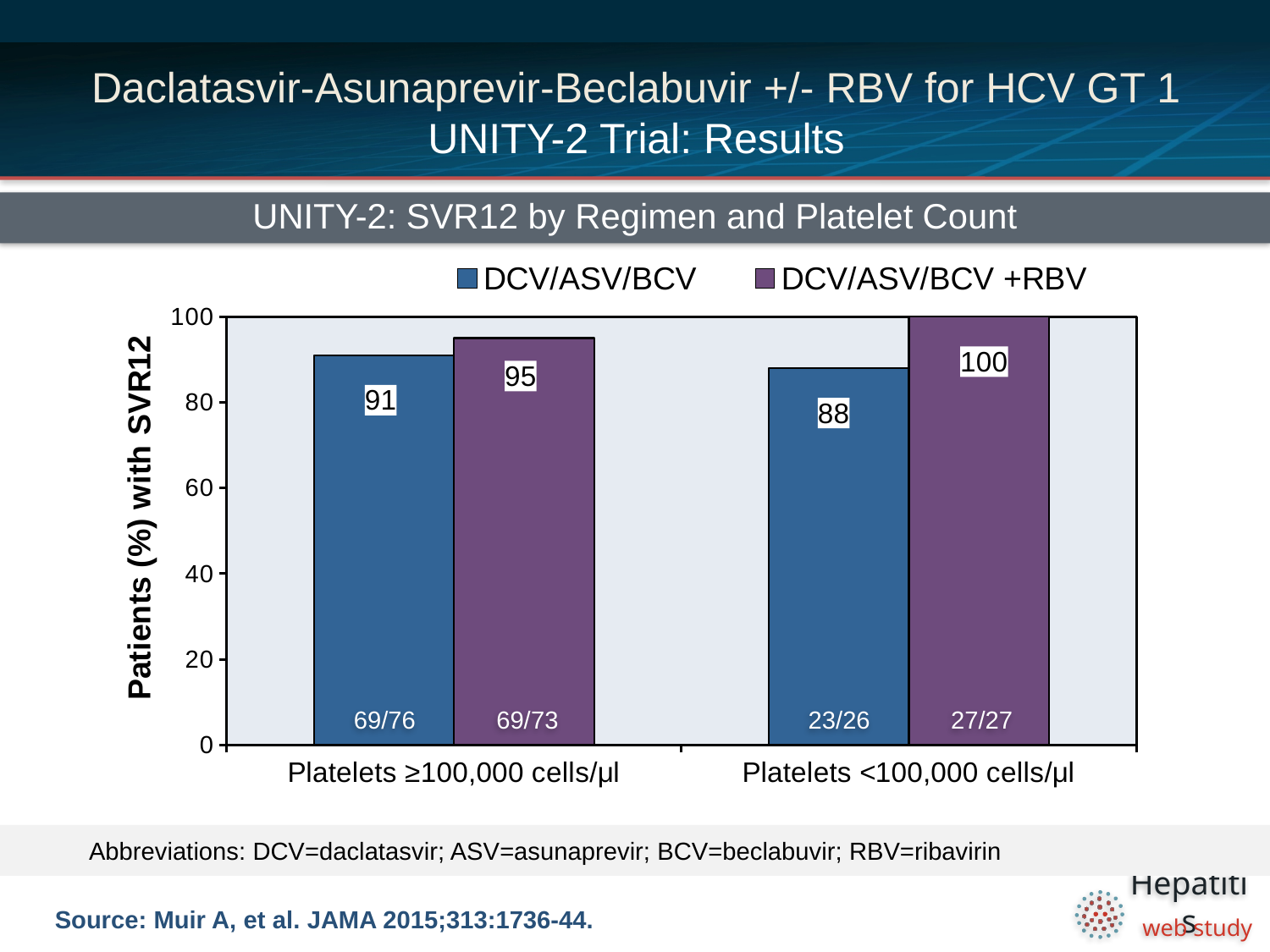
How many platelet count categories are shown on the x axis? 2 Which bar shows the highest SVR12 rate? DCV/ASV/BCV +RBV, Platelets <100,000 cells/µl Which bar shows the lowest SVR12 rate? DCV/ASV/BCV, Platelets <100,000 cells/µl What is the SVR12 rate for DCV/ASV/BCV +RBV in patients with platelets ≥100,000 cells/µl? 95 What type of chart is shown? Bar chart What is the SVR12 rate for DCV/ASV/BCV in patients with platelets ≥100,000 cells/µl? 91 Which regimen has the higher SVR12 rate in patients with platelets ≥100,000 cells/µl? DCV/ASV/BCV +RBV How many patients achieved SVR12 out of the total in the DCV/ASV/BCV +RBV group with platelets <100,000 cells/µl? 27/27 How many series does the legend list? 2 What is the SVR12 rate for DCV/ASV/BCV +RBV in patients with platelets <100,000 cells/µl? 100 What is the difference in SVR12 rate between DCV/ASV/BCV +RBV and DCV/ASV/BCV in patients with platelets <100,000 cells/µl? 12 What is the SVR12 rate for DCV/ASV/BCV in patients with platelets <100,000 cells/µl? 88